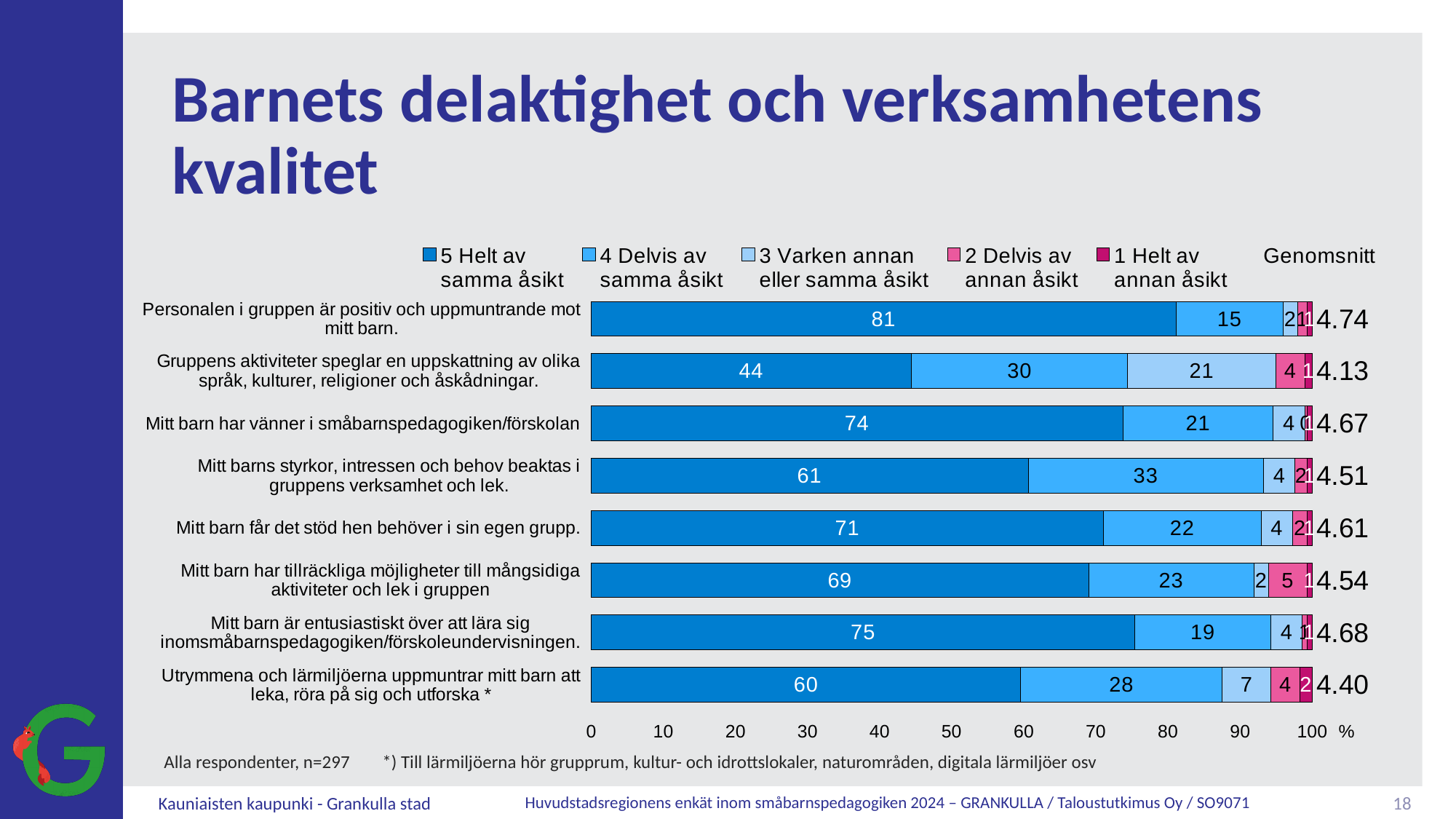
What percentage answered "3 Varken annan eller samma åsikt" for "Gruppens aktiviteter speglar en uppskattning av olika språk, kulturer, religioner och åskådningar."? 21 What is the number of respondents stated below the chart? n=297 How many statements (bars) are shown in the chart? 8 Which statement has the lowest Genomsnitt value? Gruppens aktiviteter speglar en uppskattning av olika språk, kulturer, religioner och åskådningar. (4.13) What percentage answered "4 Delvis av samma åsikt" for "Mitt barns styrkor, intressen och behov beaktas i gruppens verksamhet och lek."? 33 Which has a higher "4 Delvis av samma åsikt" percentage: "Mitt barn får det stöd hen behöver i sin egen grupp." or "Mitt barn är entusiastiskt över att lära sig inomsmåbarnspedagogiken/förskoleundervisningen."? Mitt barn får det stöd hen behöver i sin egen grupp. Which statement has the highest share of "5 Helt av samma åsikt" responses? Personalen i gruppen är positiv och uppmuntrande mot mitt barn. How many response categories (coloured series) does the legend list? 5 What is the Genomsnitt value for "Utrymmena och lärmiljöerna uppmuntrar mitt barn att leka, röra på sig och utforska *"? 4.40 What percentage of respondents answered "5 Helt av samma åsikt" for "Personalen i gruppen är positiv och uppmuntrande mot mitt barn."? 81 What is the difference in the "5 Helt av samma åsikt" percentage between "Mitt barn har vänner i småbarnspedagogiken/förskolan" and "Utrymmena och lärmiljöerna uppmuntrar mitt barn att leka, röra på sig och utforska *"? 14 What type of chart is shown on the slide? Stacked horizontal bar chart